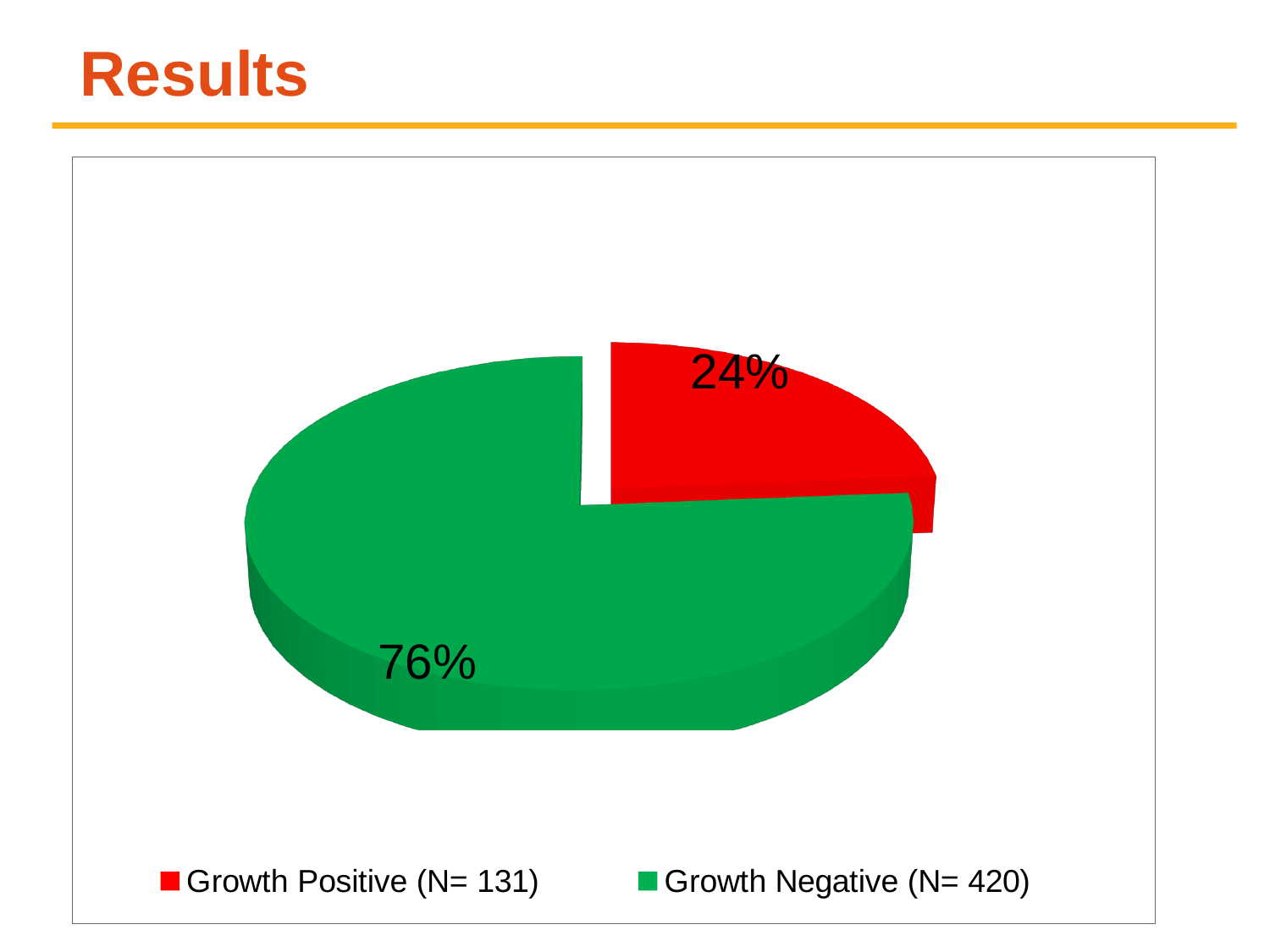
How many entries does the legend list? 2 How many slices does the pie chart have? 2 What kind of chart is shown on the slide? Pie chart What colour is the Growth Negative slice? Green What share of the pie does the Growth Positive slice represent? 24% Which slice of the pie is the largest? Growth Negative (N= 420) Which is larger, the Growth Positive slice or the Growth Negative slice? Growth Negative What is the N value shown in the legend for Growth Positive? 131 What percentage of the pie is labelled for Growth Positive? 24% Which slice of the pie is the smallest? Growth Positive (N= 131) What percentage of the pie is labelled for Growth Negative? 76% What is the difference in percentage points between the Growth Negative and Growth Positive slices? 52